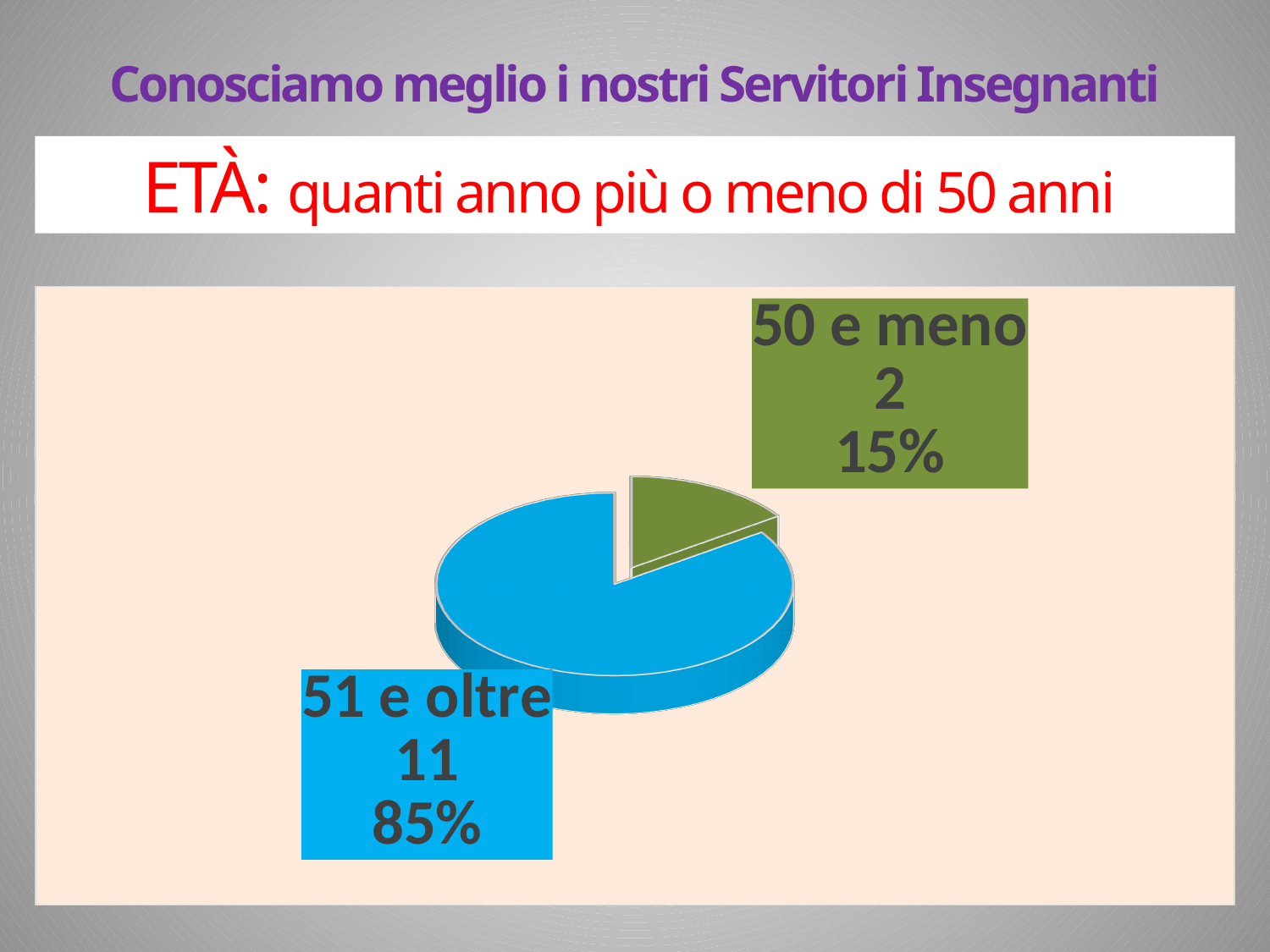
What kind of chart is shown on the slide? pie chart How many slices does the pie chart have? 2 What colour is the "50 e meno" slice? green What percentage share does the "50 e meno" slice have? 15% Which category has the smallest slice of the pie? 50 e meno What is the total count across both slices of the pie? 13 Which category has the largest slice of the pie? 51 e oltre Which is larger, the count for "51 e oltre" or the count for "50 e meno"? 51 e oltre What is the count shown for the "51 e oltre" slice? 11 What is the difference in count between "51 e oltre" and "50 e meno"? 9 What is the count shown for the "50 e meno" slice? 2 What percentage share does the "51 e oltre" slice have? 85%